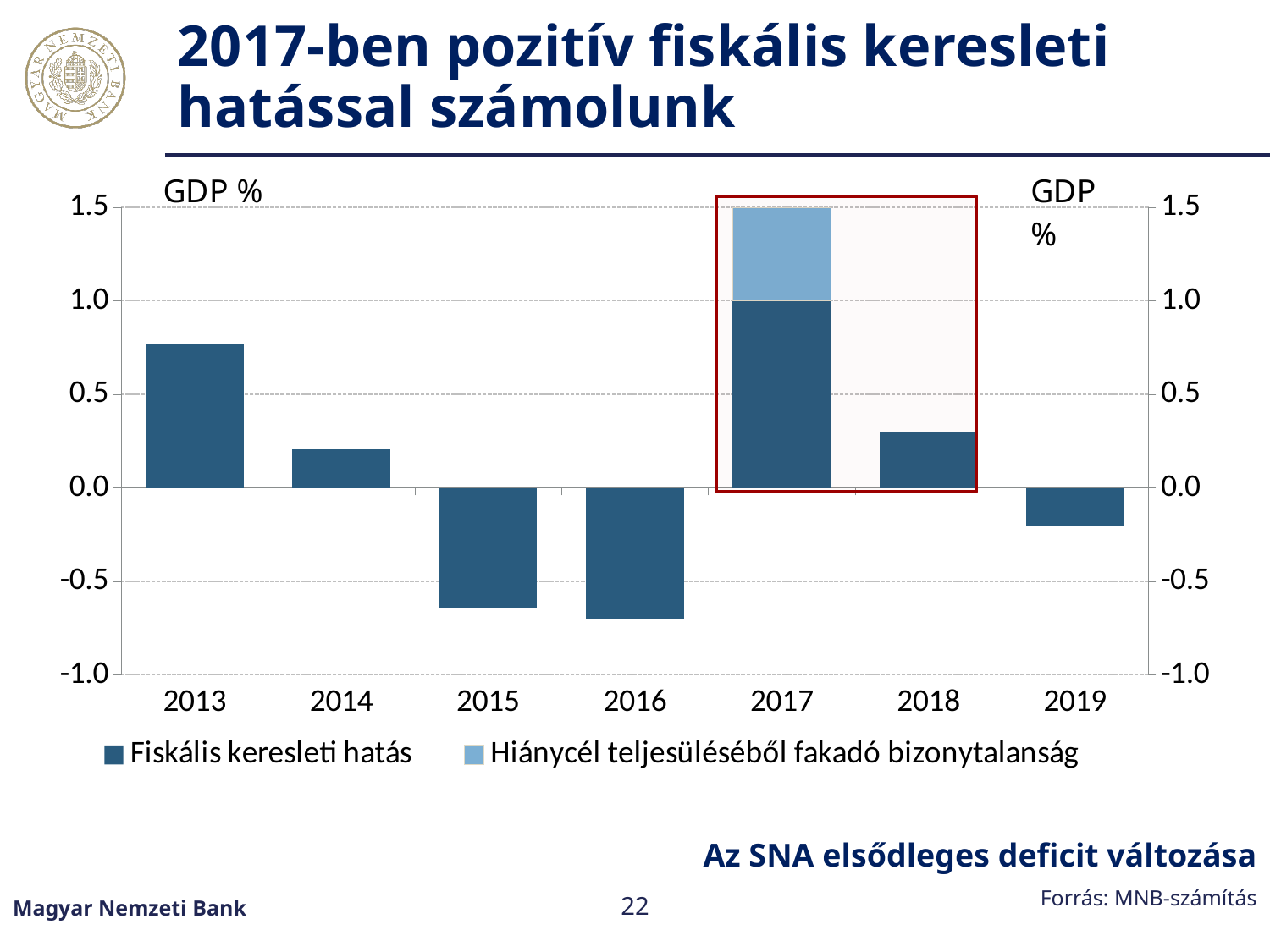
Which is larger, the value for 2013 or the value for 2014? 2013 What is the title of the chart shown below the plot area? Az SNA elsődleges deficit változása Is the value for 2013 greater or less than 0.5? greater What is the value of the 'Fiskális keresleti hatás' bar for 2017? 1.0 Which year has the lowest value in the chart? 2016 What is the top of the stacked bar for 2017, including 'Hiánycél teljesüléséből fakadó bizonytalanság'? 1.5 What kind of chart is shown on the slide? bar chart How many years are shown on the x axis of the chart? 7 Is the value for 2015 greater or less than -0.5? less How many series does the chart legend list? 2 Is the value for 2018 greater or less than 0.5? less Which year has the highest total bar in the chart? 2017